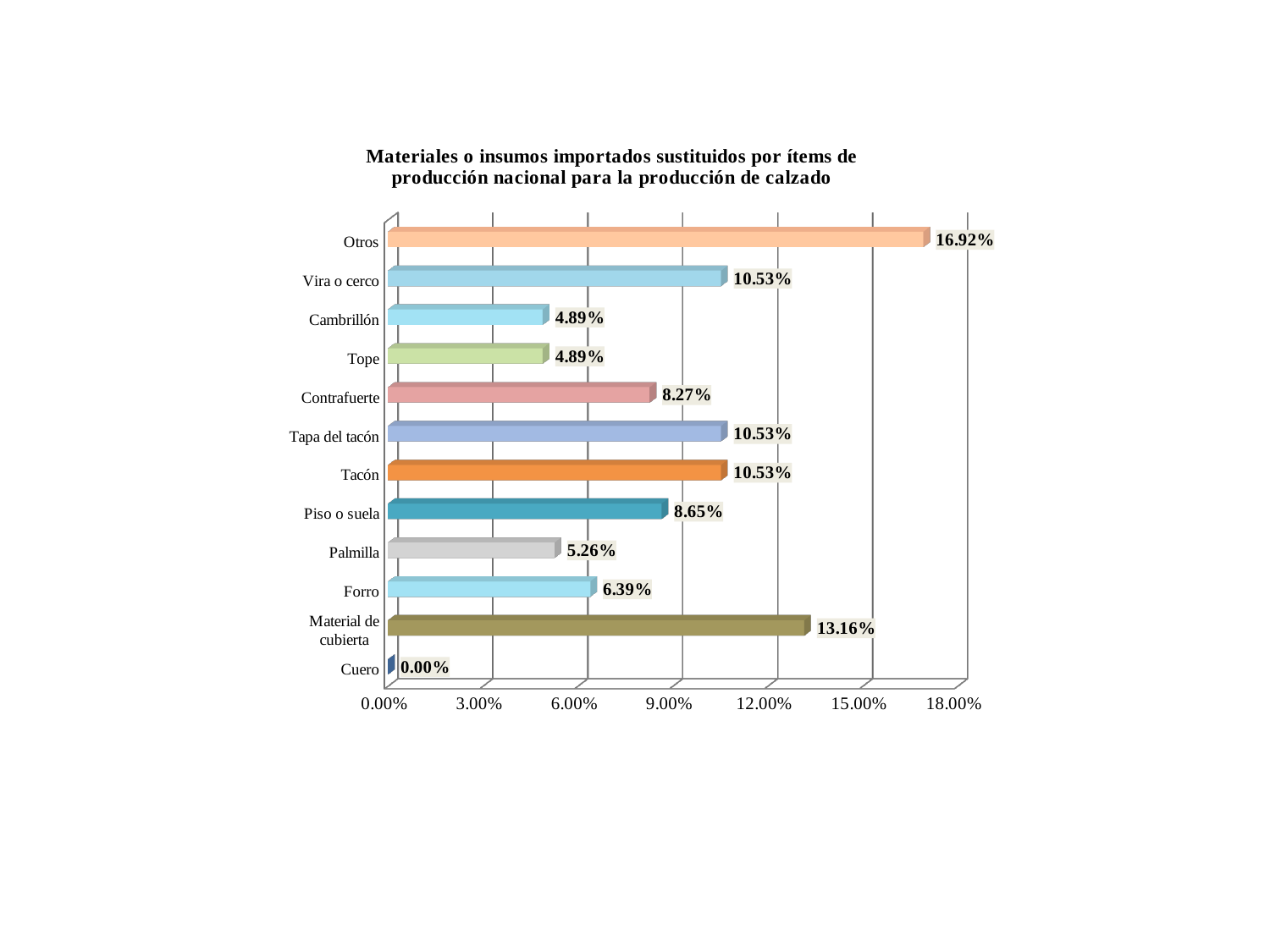
Which category has the highest value? Otros What is the title of the chart? Materiales o insumos importados sustituidos por ítems de producción nacional para la producción de calzado What is the difference between the values for Otros and Material de cubierta? 3.76% How many categories are shown in the chart? 12 What is the value for Piso o suela? 8.65% What is the value for Material de cubierta? 13.16% Which category has the lowest value? Cuero What is the value for Forro? 6.39% What is the value for Otros? 16.92% Is the value for Vira o cerco greater or less than 9.00%? greater Which is larger, the value for Contrafuerte or the value for Palmilla? Contrafuerte What kind of chart is this? Bar chart